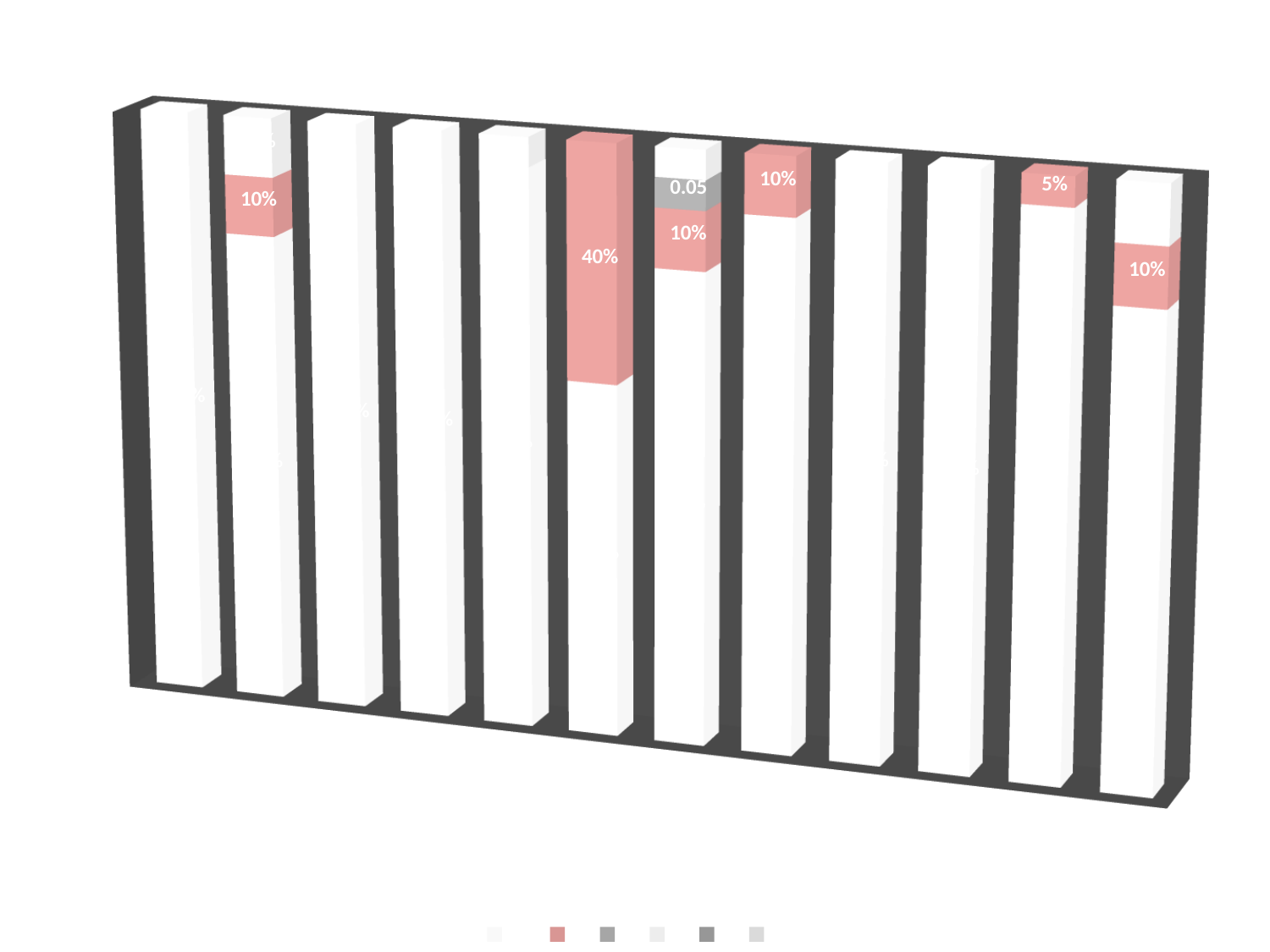
What is the value of the pink segment in the eleventh bar from the left? 5% What is the value of the pink segment in the second bar from the left? 10% What colour is the segment labelled 40%? pink What is the difference between the pink segment in the sixth bar (40%) and the pink segment in the eleventh bar (5%)? 35% What is the value of the grey segment in the seventh bar from the left? 0.05 How many series does the legend list? 6 What kind of chart is shown on the slide? bar chart Which bar has the largest labelled pink segment? the sixth bar from the left Which is larger: the pink segment in the sixth bar from the left or the pink segment in the eighth bar from the left? the sixth bar What is the value of the pink segment in the twelfth bar from the left? 10% What is the value of the pink segment in the sixth bar from the left? 40% How many bars are plotted in the chart? 12